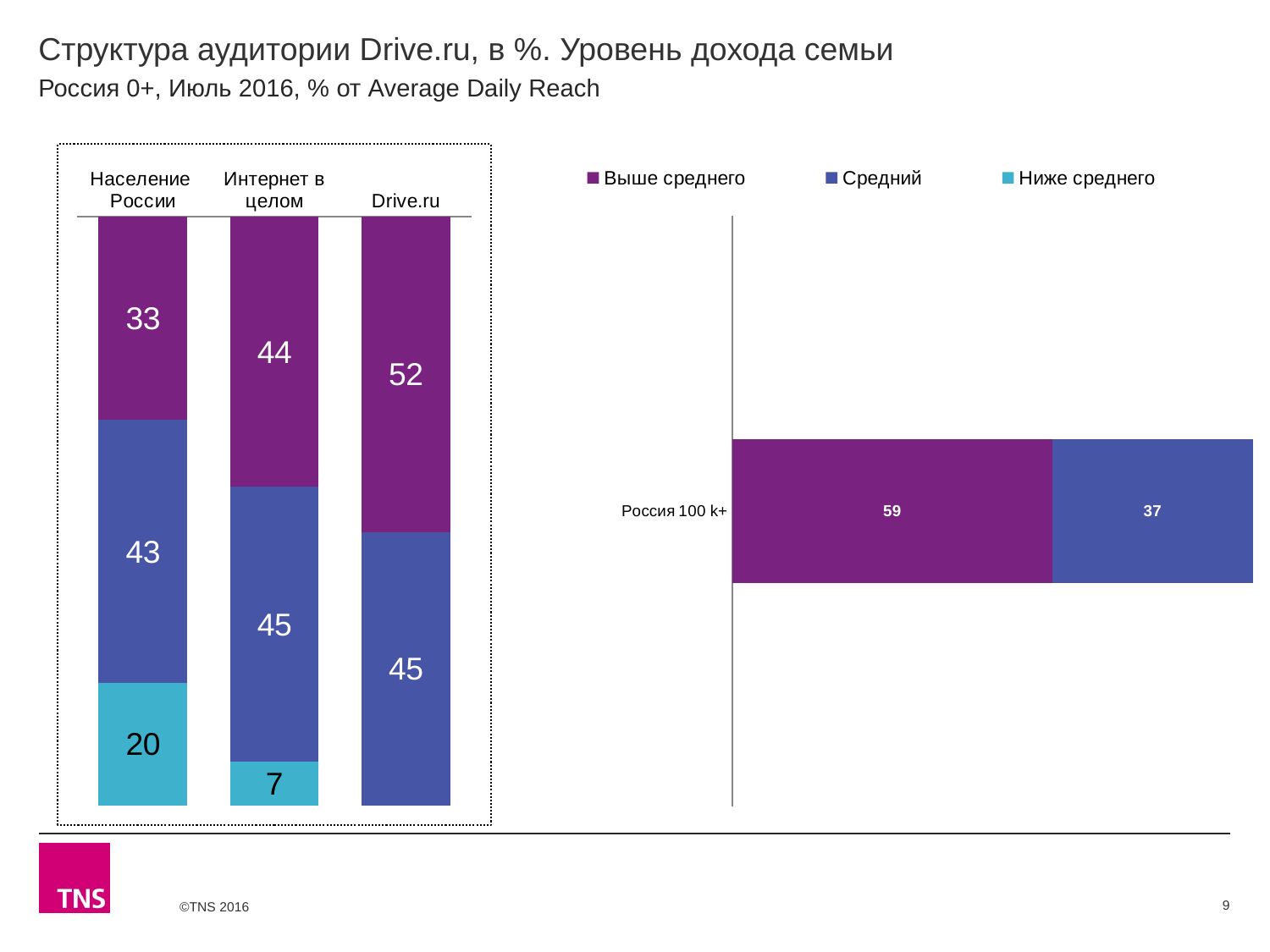
In the left chart, what is the difference between the 'Выше среднего' values for Drive.ru and 'Население России'? 19 In the left chart, which category has the lowest 'Ниже среднего' value among those with a labelled segment? Интернет в целом What type of chart is the right chart? Stacked bar chart In the left chart, what is the value of the 'Ниже среднего' segment for 'Население России'? 20 In the left chart, which is larger: the 'Средний' value for 'Население России' or for Drive.ru? Drive.ru In the left chart, what is the value of the 'Выше среднего' segment for Drive.ru? 52 In the right chart, what is the value of the 'Средний' segment for 'Россия 100 k+'? 37 How many categories are shown on the x axis of the left chart? 3 How many series does the legend list? 3 In the left chart, what is the value of the 'Средний' segment for 'Интернет в целом'? 45 In the right chart, what is the value of the 'Выше среднего' segment for 'Россия 100 k+'? 59 In the left chart, which category has the highest 'Выше среднего' value? Drive.ru